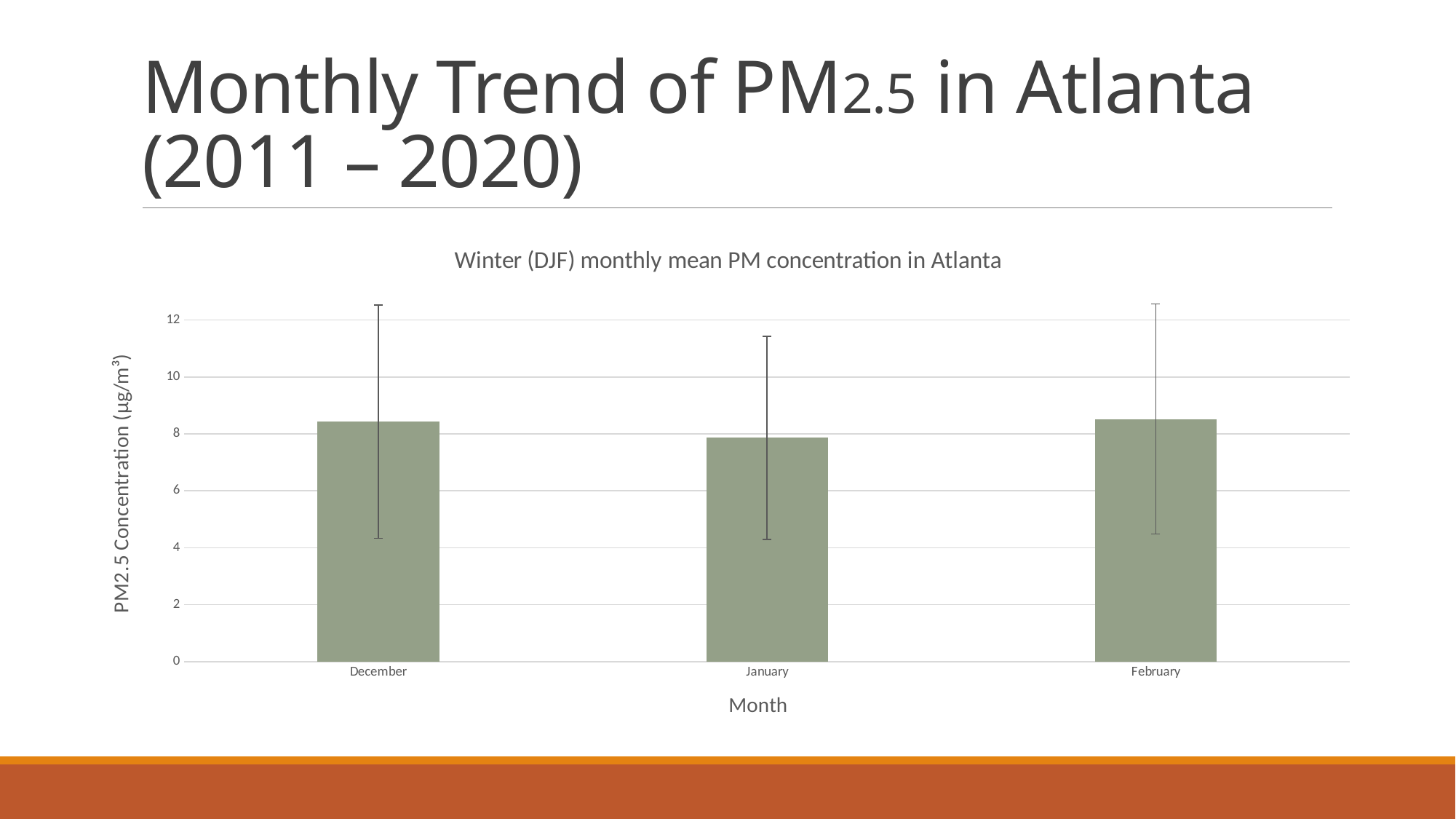
Which is larger, the mean PM2.5 concentration for December or for January? December Is the value for January greater or less than 6? greater What is the title of the chart? Winter (DJF) monthly mean PM concentration in Atlanta How many months are plotted on the chart? 3 Which month has the lowest mean PM2.5 concentration? January What kind of chart is shown on the slide? bar chart Which is larger, the mean PM2.5 concentration for February or for January? February Is the value for December greater or less than 8? greater Is the value for February greater or less than 10? less What is the label of the x axis? Month